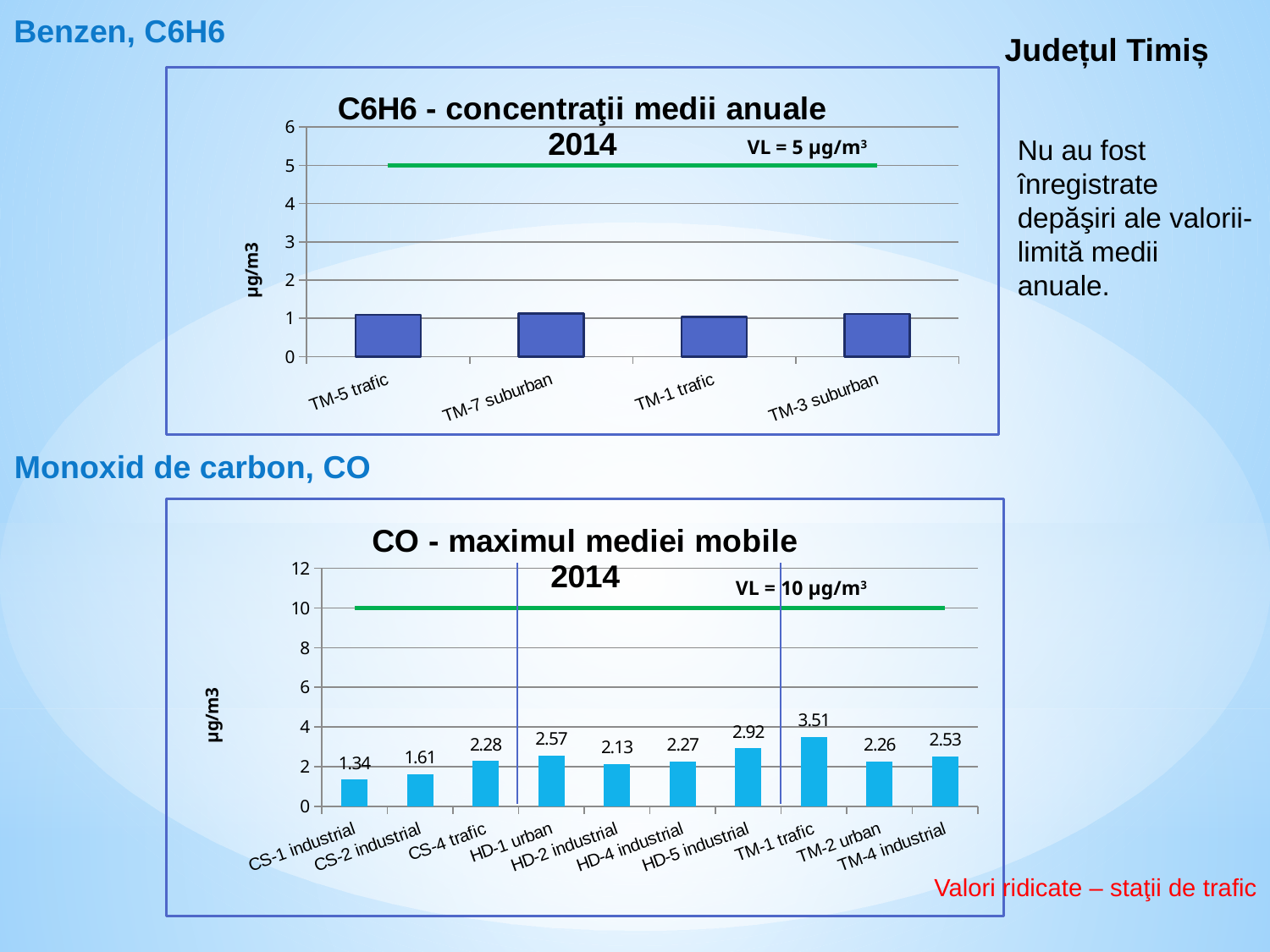
In the 'CO - maximul mediei mobile 2014' chart, which is larger: the value for HD-1 urban or the value for TM-4 industrial? HD-1 urban In the 'CO - maximul mediei mobile 2014' chart, what is the difference between the values for TM-1 trafic and CS-1 industrial? 2.17 What limit value (VL) is shown on the 'CO - maximul mediei mobile 2014' chart? VL = 10 µg/m³ In the 'CO - maximul mediei mobile 2014' chart, which station has the highest value? TM-1 trafic In the 'CO - maximul mediei mobile 2014' chart, what is the value for CS-1 industrial? 1.34 In the 'CO - maximul mediei mobile 2014' chart, which station has the lowest value? CS-1 industrial What kind of chart is the 'C6H6 - concentraţii medii anuale 2014' chart? bar chart In the 'C6H6 - concentraţii medii anuale 2014' chart, is the value for TM-5 trafic greater or less than 2? less How many stations are shown in the 'CO - maximul mediei mobile 2014' chart? 10 How many stations are shown in the 'C6H6 - concentraţii medii anuale 2014' chart? 4 In the 'CO - maximul mediei mobile 2014' chart, what is the value for TM-1 trafic? 3.51 In the 'CO - maximul mediei mobile 2014' chart, what is the value for HD-5 industrial? 2.92